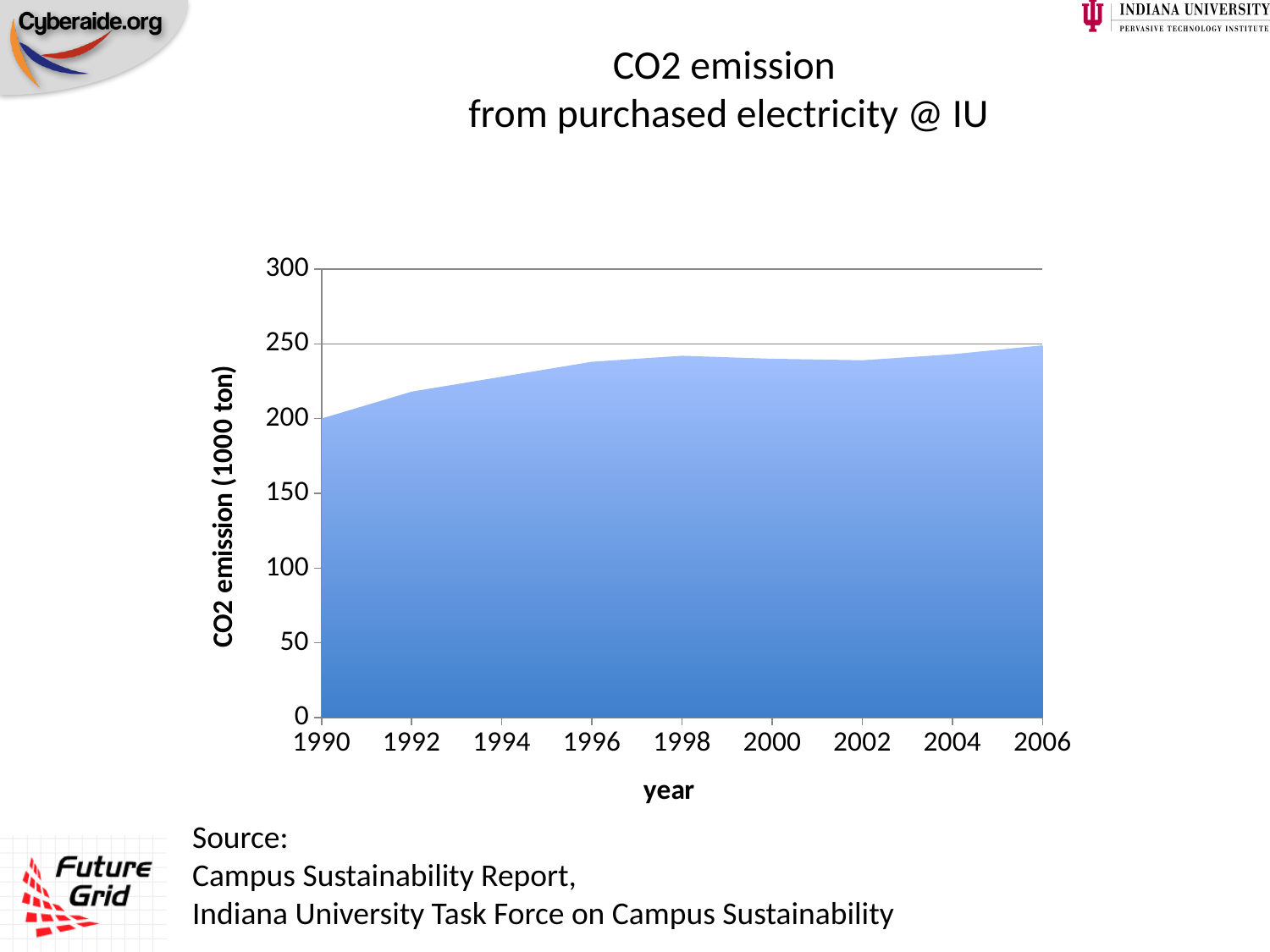
Which year has the larger CO2 emission value, 1990 or 2006? 2006 What is the label of the y axis? CO2 emission (1000 ton) Which year has the larger CO2 emission value, 1992 or 2000? 2000 Is the CO2 emission value for 1998 greater or less than 200? greater Do the CO2 emission values generally rise or fall from 1990 to 2006? rise Which year has the highest CO2 emission value? 2006 What is the title of the chart? CO2 emission from purchased electricity @ IU Is the CO2 emission value for 1990 greater or less than 150? greater What kind of chart is shown on the slide? area chart Is the CO2 emission value for 2002 greater or less than 300? less Which year has the lowest CO2 emission value? 1990